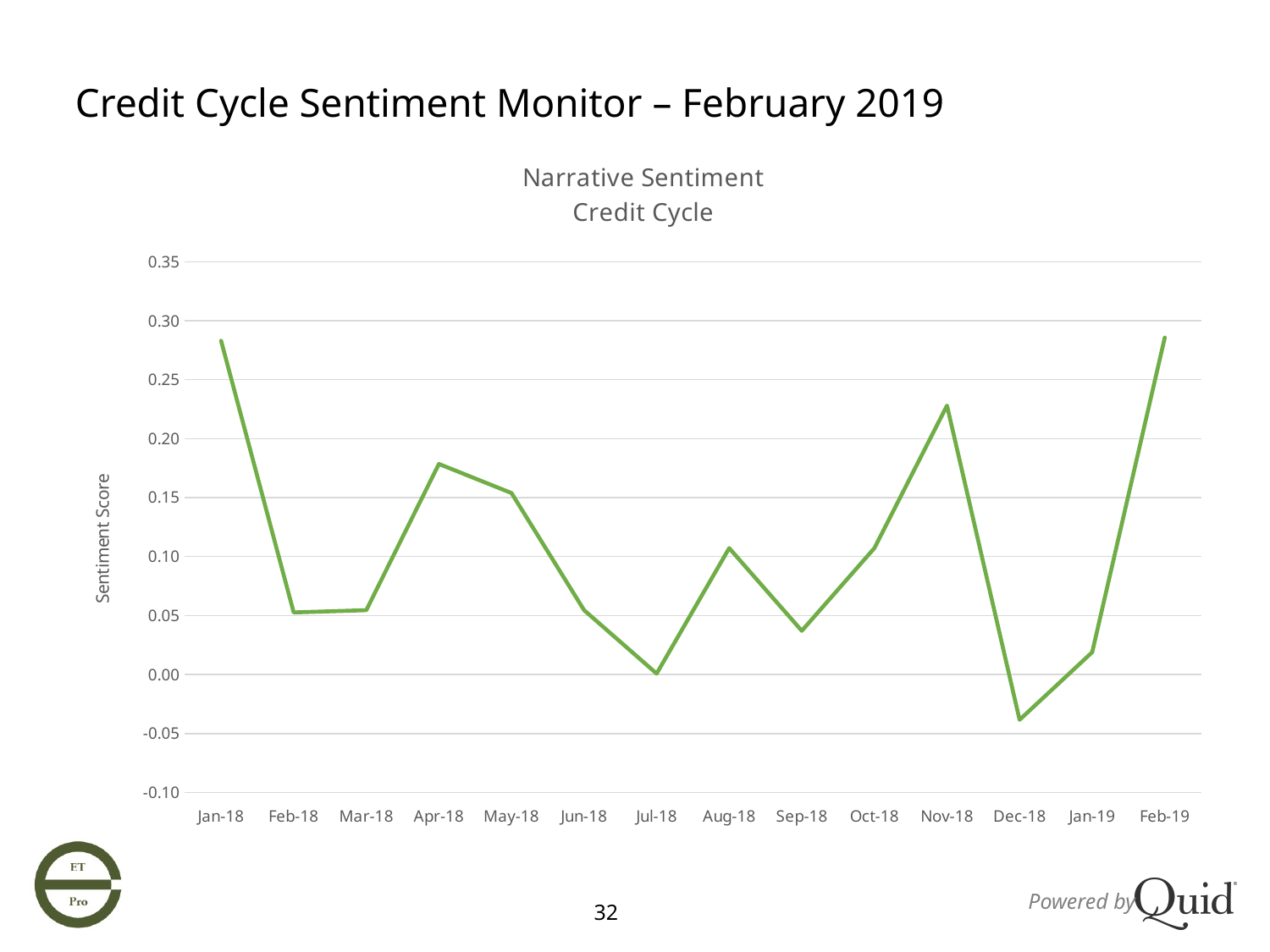
Is the sentiment score for Nov-18 greater or less than 0.20? greater Is the sentiment score for Dec-18 greater or less than 0.00? less Is the sentiment score for Sep-18 greater or less than 0.05? less Does the sentiment score rise or fall from Jan-18 to Feb-18? fall Does the sentiment score rise or fall from Dec-18 to Feb-19? rise Which month has the lowest sentiment score? Dec-18 What kind of chart is shown on the slide? line chart Which month has the higher sentiment score, Oct-18 or Nov-18? Nov-18 Which month has the higher sentiment score, Apr-18 or Jun-18? Apr-18 What is the label on the vertical axis of the chart? Sentiment Score How many monthly data points are plotted on the chart? 14